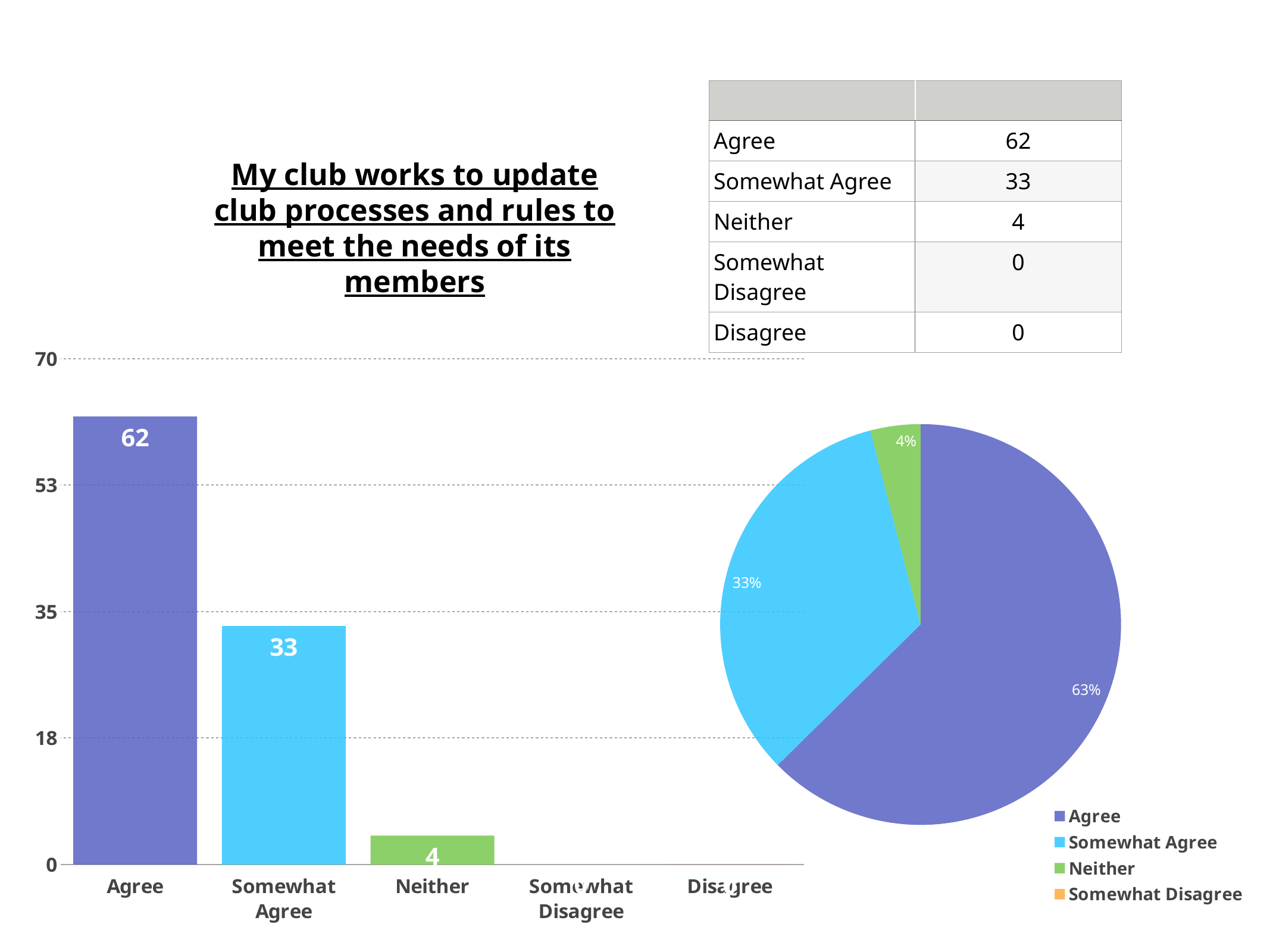
In the bar chart on the left, which is larger, the value for Somewhat Agree or the value for Neither? Somewhat Agree In the pie chart on the right, what share does the Somewhat Agree slice have? 33% In the bar chart on the left, what is the value for Somewhat Agree? 33 In the bar chart on the left, how many categories are shown on the x axis? 5 In the bar chart on the left, what is the value for Agree? 62 In the bar chart on the left, what is the difference between the values for Agree and Somewhat Agree? 29 How many entries does the legend of the pie chart on the right list? 4 In the pie chart on the right, what share does the Agree slice have? 63% In the pie chart on the right, what share does the Neither slice have? 4% What kind of chart is on the left side of the slide? bar chart In the bar chart on the left, what is the value for Neither? 4 In the bar chart on the left, which category has the highest value? Agree